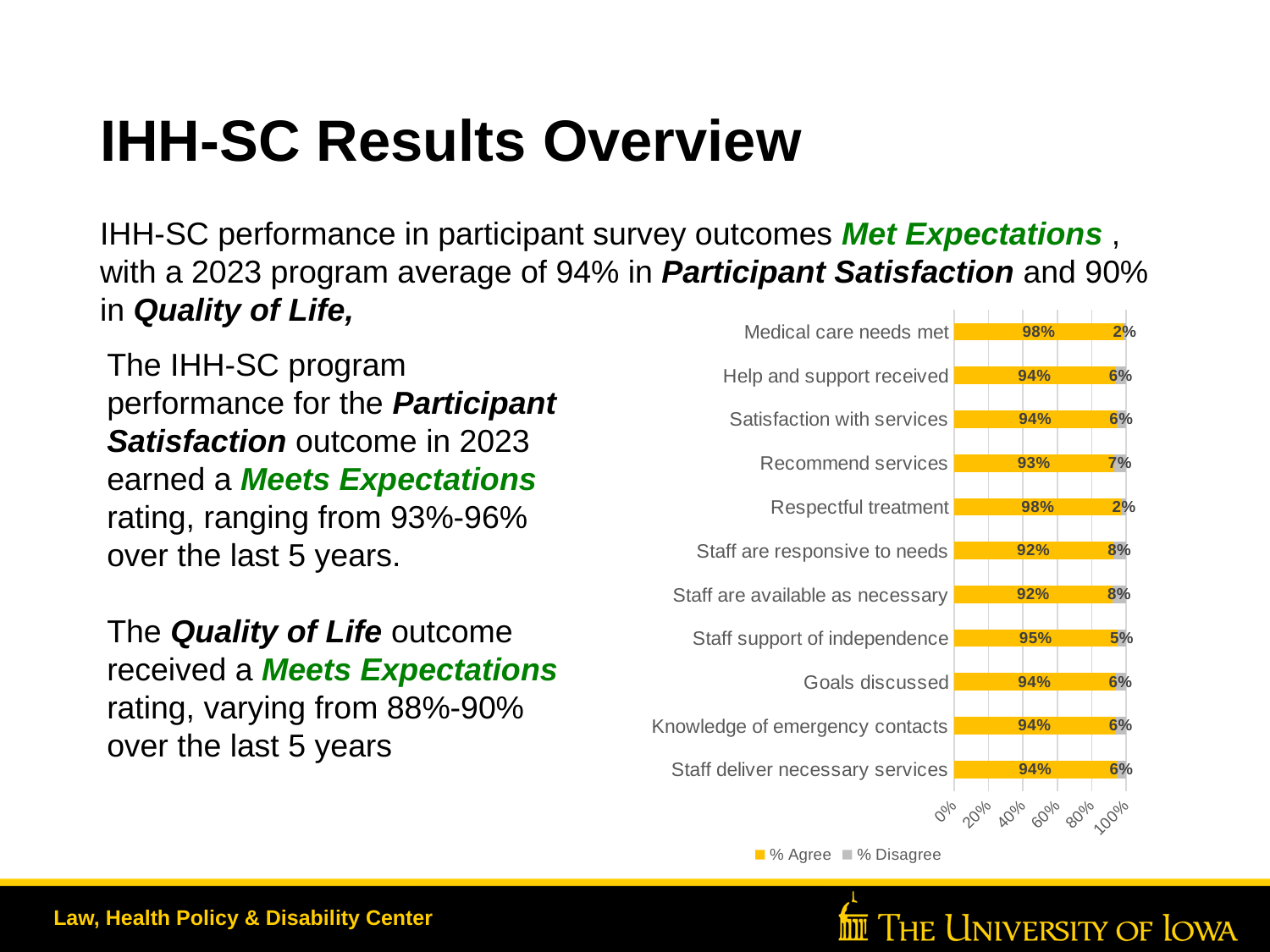
What is the difference between the % Agree values for Medical care needs met and Staff are responsive to needs? 6% What is the % Agree value for Medical care needs met? 98% What is the lowest % Agree value shown in the chart? 92% What is the % Disagree value for Recommend services? 7% How many series does the legend list? 2 Which category has the highest % Disagree value? Staff are responsive to needs and Staff are available as necessary (8%) How many categories are shown in the chart? 11 What is the total of the stacked bar for Respectful treatment? 100% Which colour represents % Agree in the chart? Yellow Which has a larger % Agree value, Recommend services or Staff support of independence? Staff support of independence What kind of chart is shown on the slide? Stacked horizontal bar chart What is the % Agree value for Staff support of independence? 95%